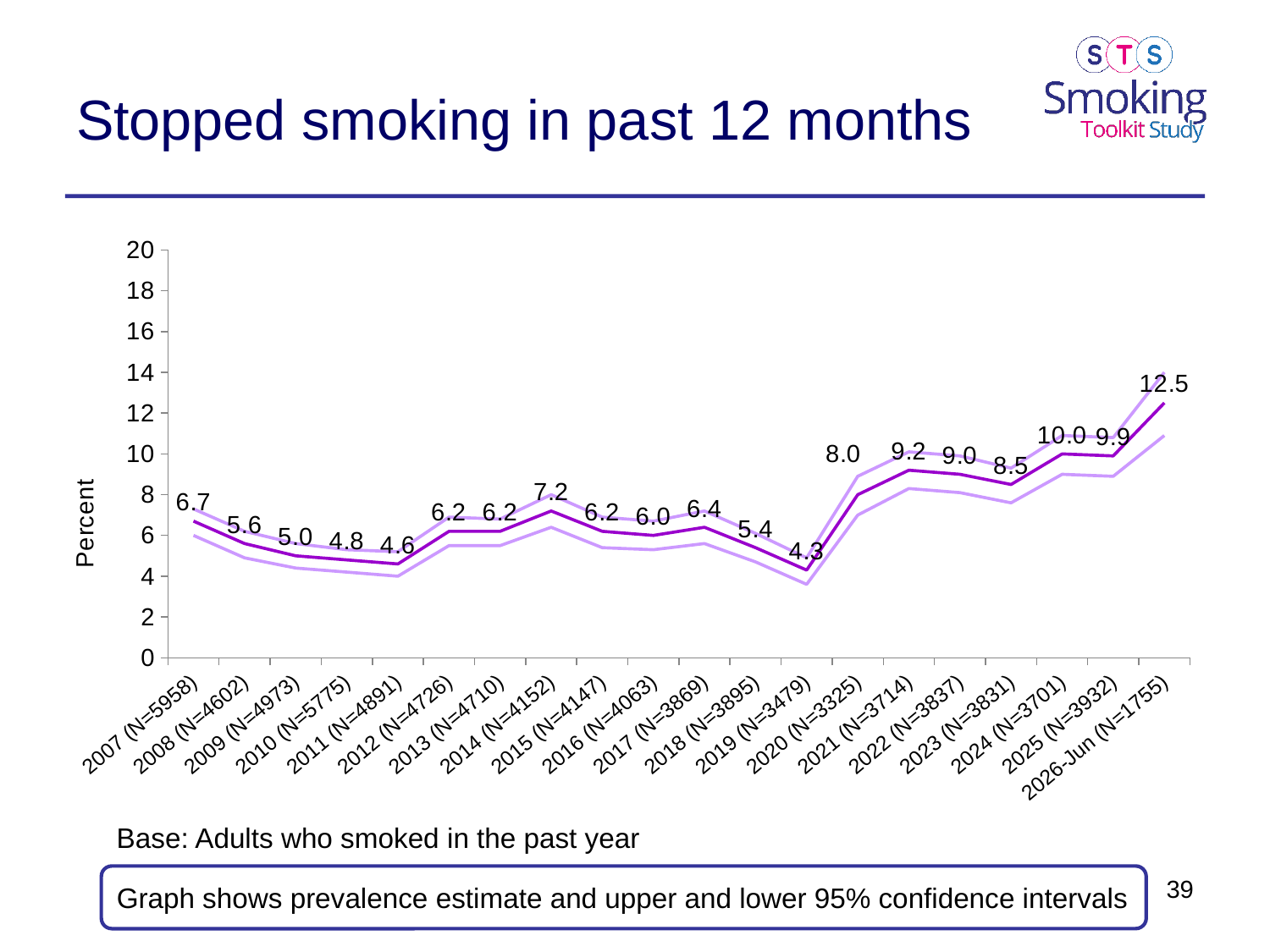
What is the value for 2019 (N=3479)? 4.3 Do the values rise or fall from 2019 (N=3479) to 2021 (N=3714)? Rise What kind of chart is shown on the slide? Line chart Which is larger, the value for 2021 (N=3714) or the value for 2023 (N=3831)? 2021 (N=3714) What is the difference between the values for 2026-Jun (N=1755) and 2025 (N=3932)? 2.6 What is the value for 2024 (N=3701)? 10.0 What is the value for 2007 (N=5958)? 6.7 What is the label of the y axis? Percent How many categories are shown on the x axis? 20 Which category has the highest value? 2026-Jun (N=1755) Which category has the lowest value? 2019 (N=3479) What is the value for 2014 (N=4152)? 7.2